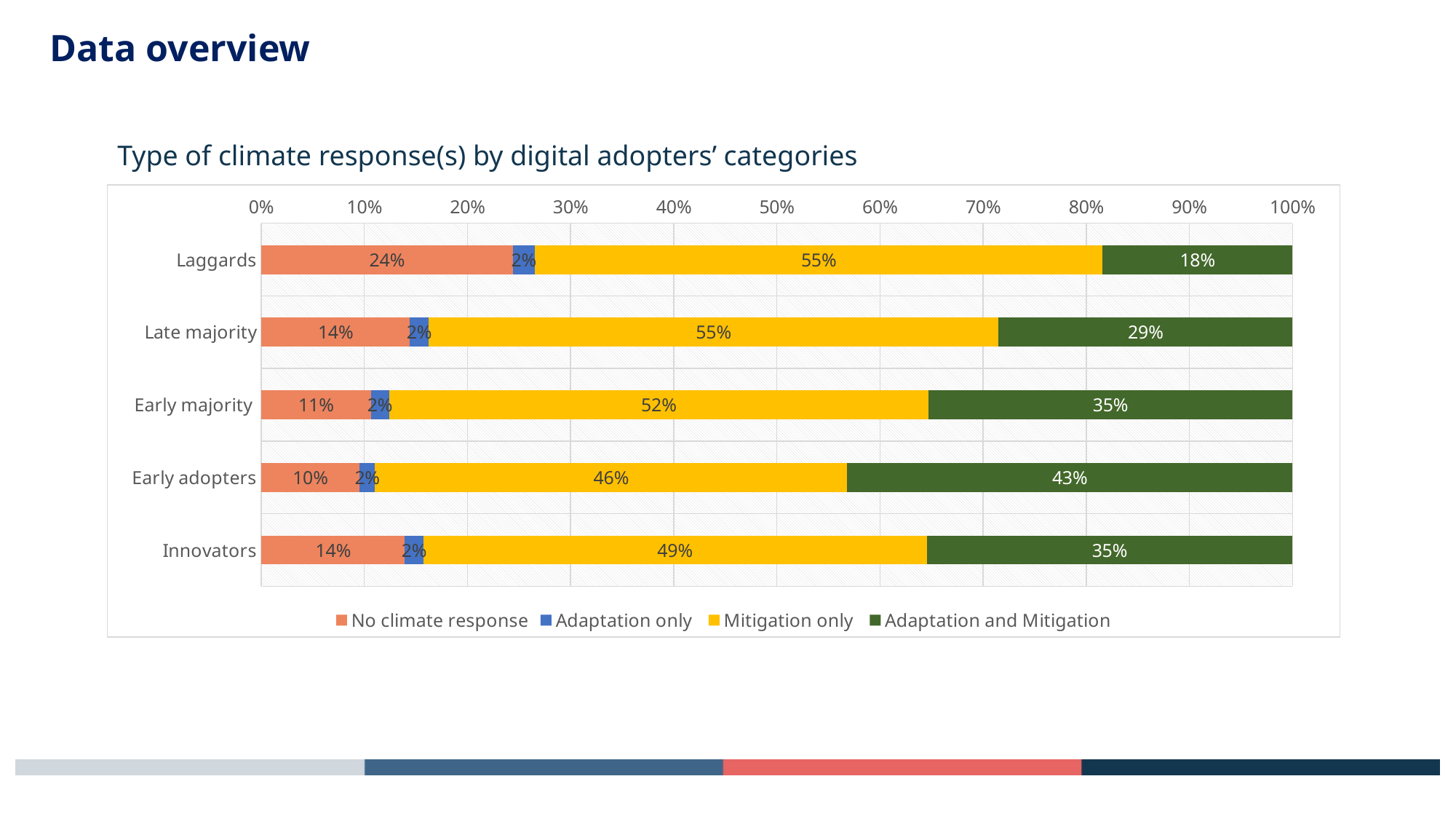
Which category has the highest Adaptation and Mitigation share? Early adopters Which category has the highest No climate response share? Laggards Which category has the lowest Adaptation and Mitigation share? Laggards What is the title of the chart? Type of climate response(s) by digital adopters' categories How many digital adopter categories are shown on the chart? 5 How many series does the legend list? 4 What is the difference between the Adaptation and Mitigation values for Early adopters and Laggards? 25% What is the Adaptation and Mitigation value for Early adopters? 43% What percentage of Laggards have no climate response? 24% Is the Mitigation only value larger for Laggards or for Early adopters? Laggards What kind of chart is shown on the slide? Stacked bar chart What is the Mitigation only value for Innovators? 49%